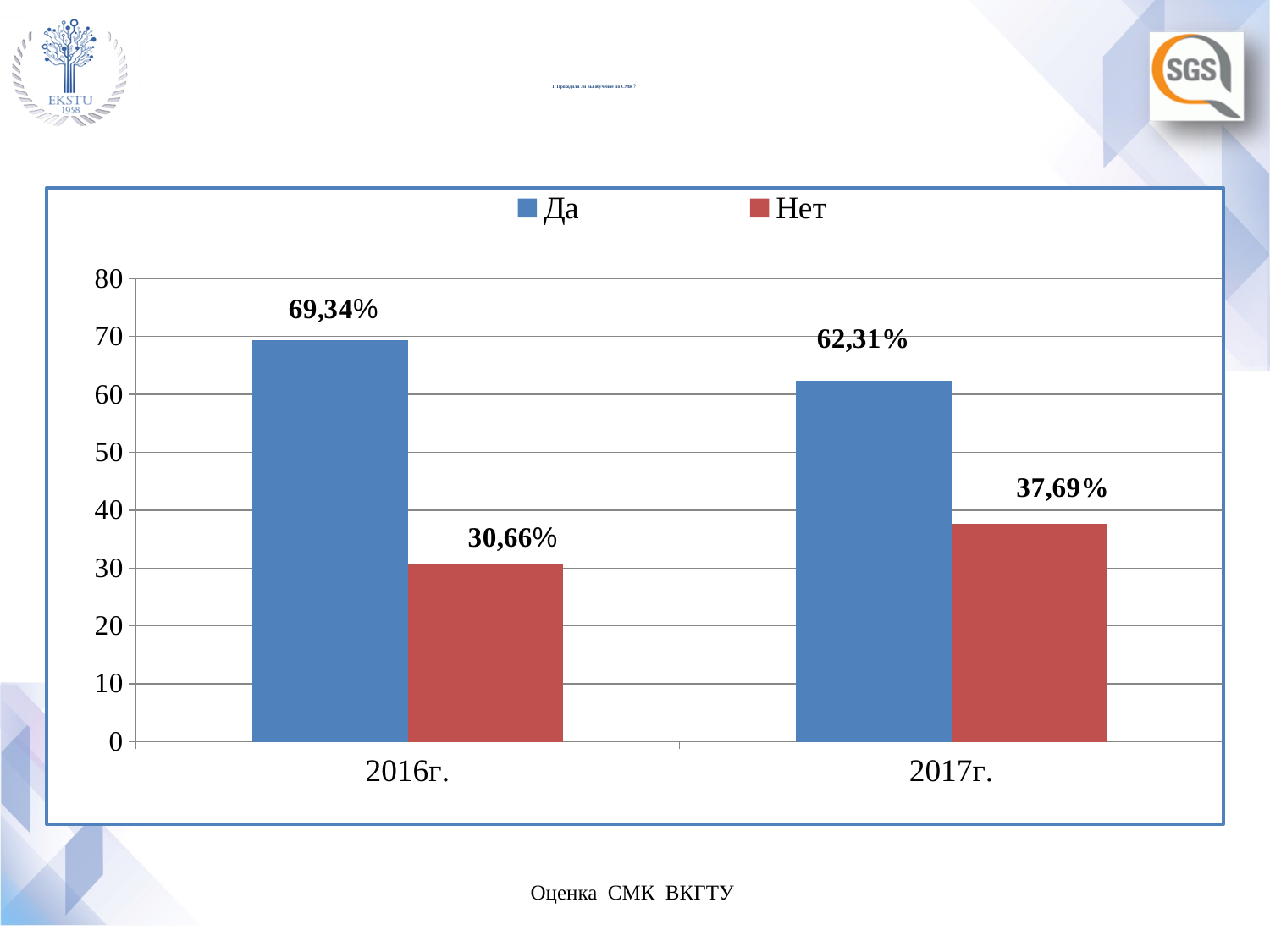
What kind of chart is shown on the slide? Bar chart How many categories are shown on the x axis? 2 How many series does the legend list? 2 What is the value for "Да" in 2017г.? 62,31% What is the value for "Да" in 2016г.? 69,34% Which year has the lowest value for "Нет"? 2016г. Which year has the highest value for "Да"? 2016г. What is the difference between the "Да" values for 2016г. and 2017г.? 7,03% What is the value for "Нет" in 2017г.? 37,69% What is the value for "Нет" in 2016г.? 30,66% Does the value for "Нет" rise or fall from 2016г. to 2017г.? Rise Which is larger in 2017г., "Да" or "Нет"? Да